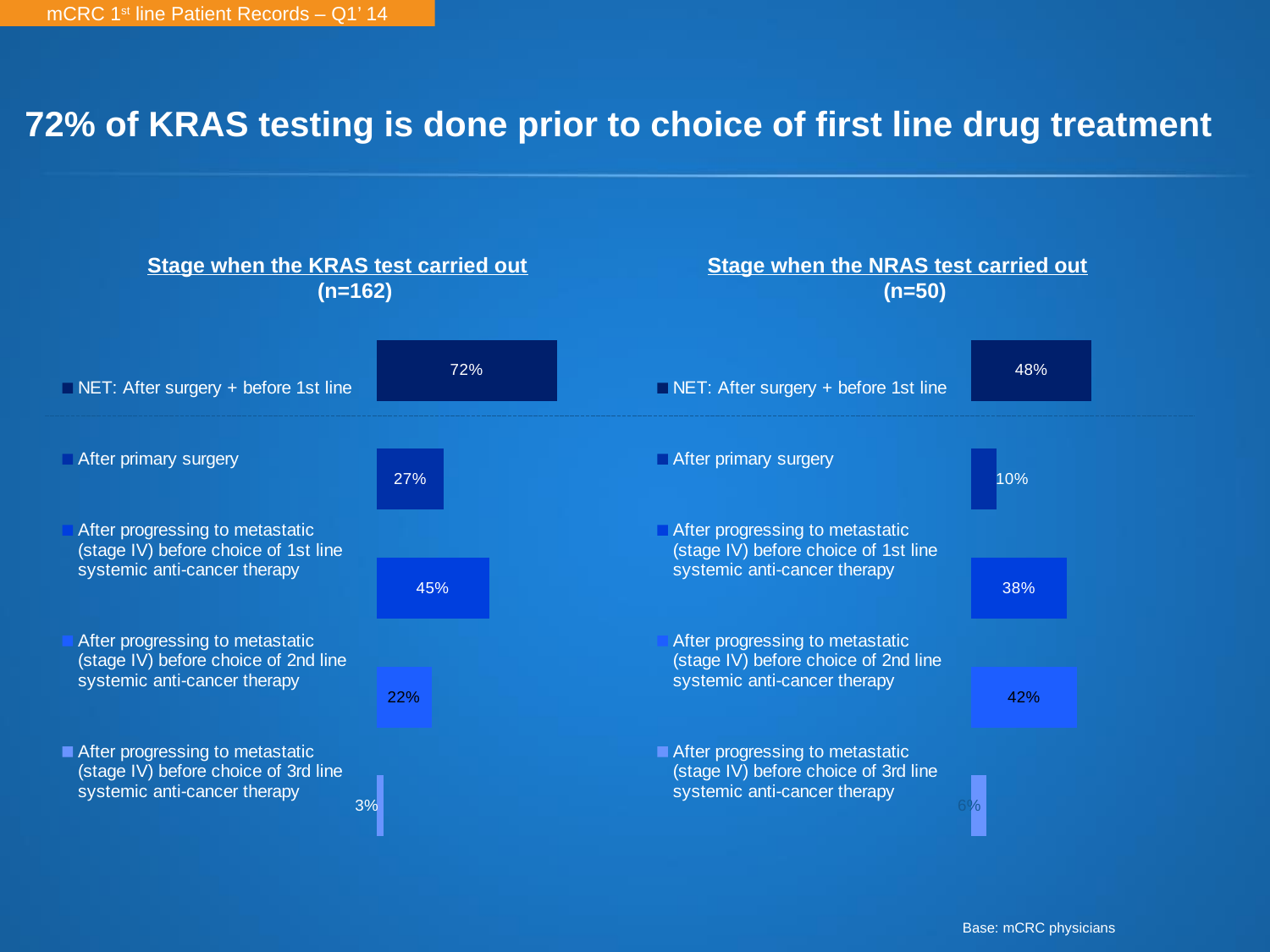
In the 'Stage when the NRAS test carried out' chart, what is the value for 'After primary surgery'? 10% In the 'Stage when the NRAS test carried out' chart, which is larger: 'before choice of 1st line' or 'before choice of 2nd line'? before choice of 2nd line Which chart has the larger value for 'NET: After surgery + before 1st line', the KRAS chart or the NRAS chart? KRAS chart In the 'Stage when the NRAS test carried out' chart, which stage has the lowest value? After progressing to metastatic (stage IV) before choice of 3rd line systemic anti-cancer therapy What is the sample size (n) shown in the title of the 'Stage when the NRAS test carried out' chart? n=50 In the 'Stage when the KRAS test carried out' chart, excluding the NET bar, which stage has the highest value? After progressing to metastatic (stage IV) before choice of 1st line systemic anti-cancer therapy How many bars are shown in the 'Stage when the KRAS test carried out' chart? 5 In the 'Stage when the KRAS test carried out' chart, what is the difference between the values for 'before choice of 1st line' (45%) and 'before choice of 2nd line' (22%)? 23% What type of chart is used for 'Stage when the NRAS test carried out'? Bar chart In the 'Stage when the KRAS test carried out' chart, what is the value for 'NET: After surgery + before 1st line'? 72% In the 'Stage when the NRAS test carried out' chart, what is the value for 'After progressing to metastatic (stage IV) before choice of 2nd line systemic anti-cancer therapy'? 42% In the 'Stage when the KRAS test carried out' chart, what is the value for 'After primary surgery'? 27%